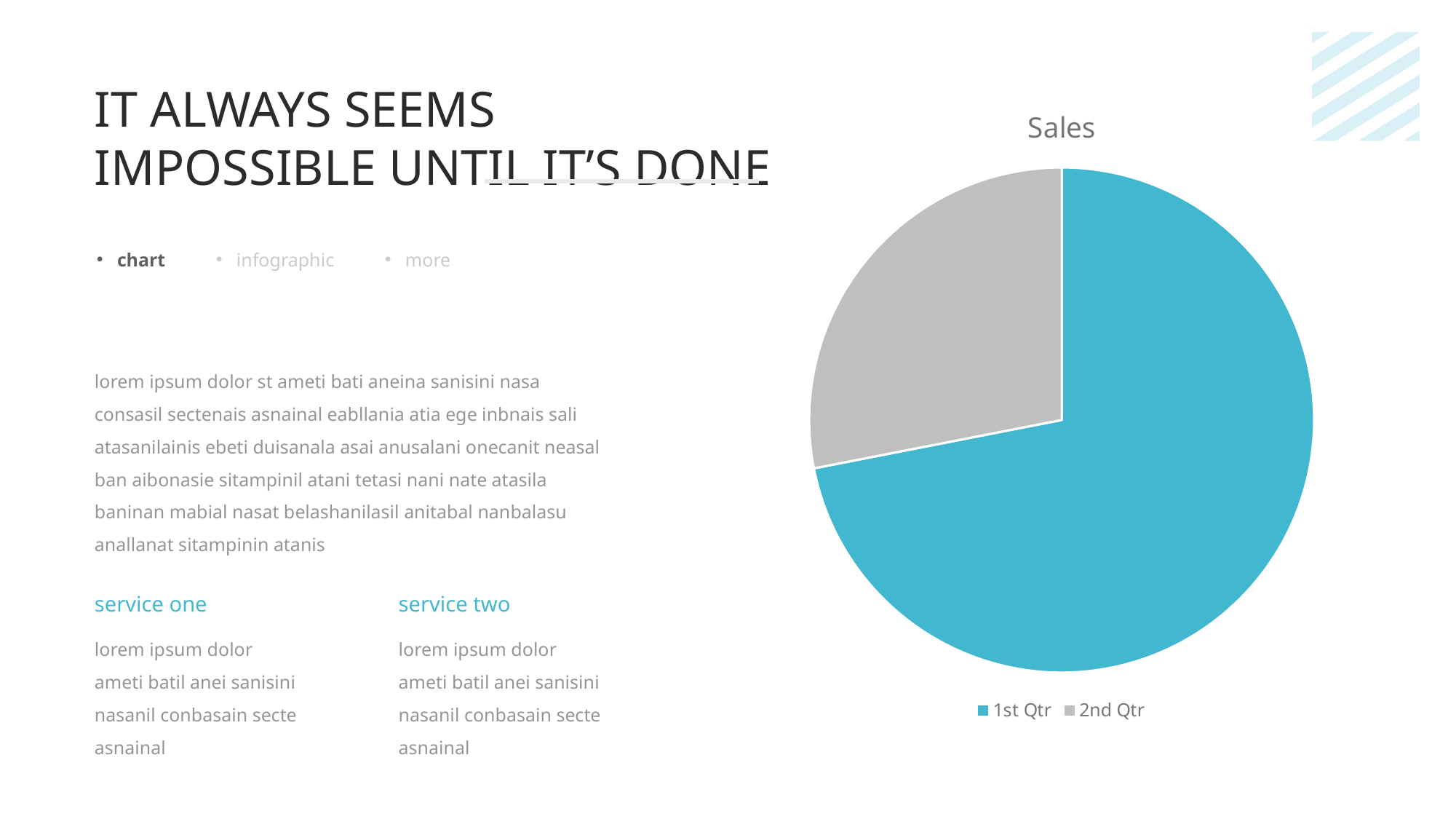
What is the title of the chart? Sales What colour is the 1st Qtr slice? blue Which slice is the largest in the pie chart? 1st Qtr How many slices does the pie chart have? 2 Which is larger, the 1st Qtr slice or the 2nd Qtr slice? 1st Qtr What kind of chart is shown on the slide? pie chart How many entries does the legend list? 2 Which slice is the smallest in the pie chart? 2nd Qtr